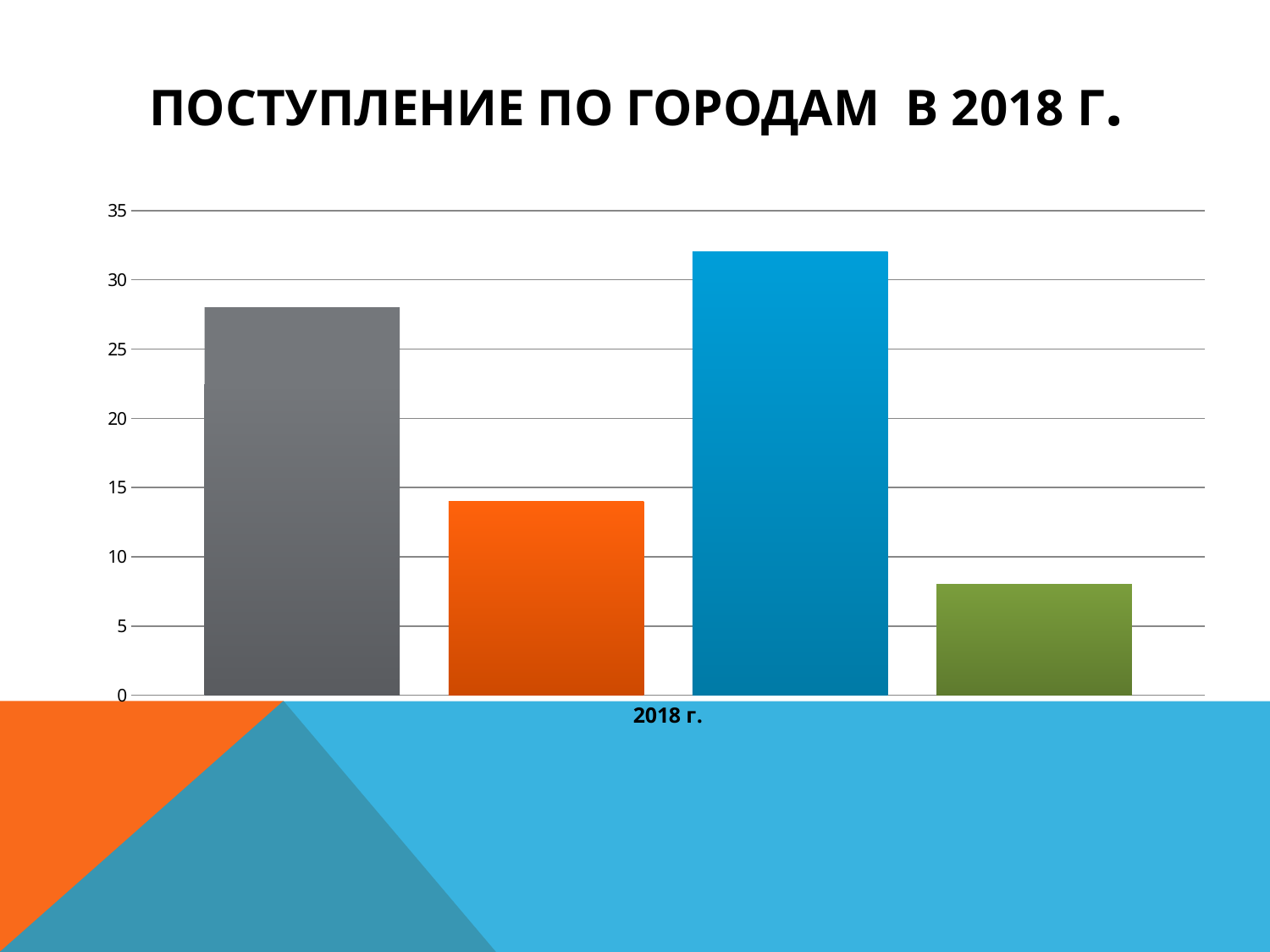
Which is larger, the gray bar or the orange bar? the gray bar Which bar is the tallest in the chart? the blue bar What label is shown on the horizontal axis of the chart? 2018 г. How many bars are plotted in the chart? 4 Which bar is the shortest in the chart? the green bar Which is larger, the orange bar or the green bar? the orange bar What kind of chart is shown on the slide? bar chart What is the title of the chart? ПОСТУПЛЕНИЕ ПО ГОРОДАМ В 2018 Г. Is the value of the orange bar greater or less than 15? less Is the value of the gray bar greater or less than 25? greater Is the value of the blue bar greater or less than 30? greater